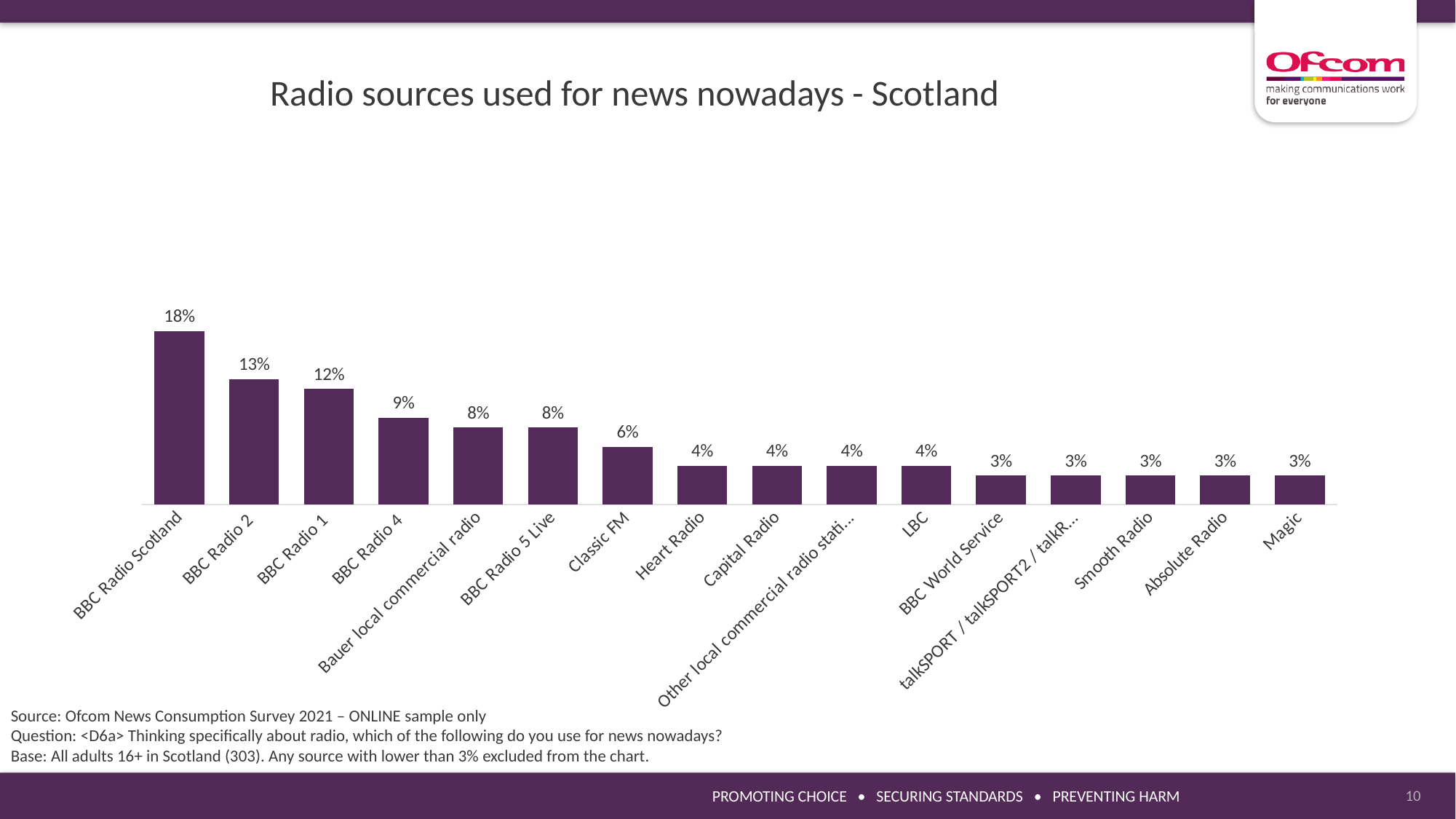
What is the value shown for BBC Radio 4? 9% Which has a higher value, BBC Radio 2 or BBC Radio 4? BBC Radio 2 How many radio sources are shown on the chart? 16 What is the value shown for Classic FM? 6% Which has a higher value, Classic FM or LBC? Classic FM Which radio source has the highest value on the chart? BBC Radio Scotland What percentage of adults in Scotland use BBC Radio Scotland for news nowadays? 18% What is the value shown for Heart Radio? 4% Do the values rise or fall from left to right across the chart? Fall What kind of chart is shown on the slide? Bar chart What is the difference between the values for BBC Radio Scotland and BBC Radio 2? 5% What is the difference between the values for BBC Radio 1 and BBC Radio 5 Live? 4%